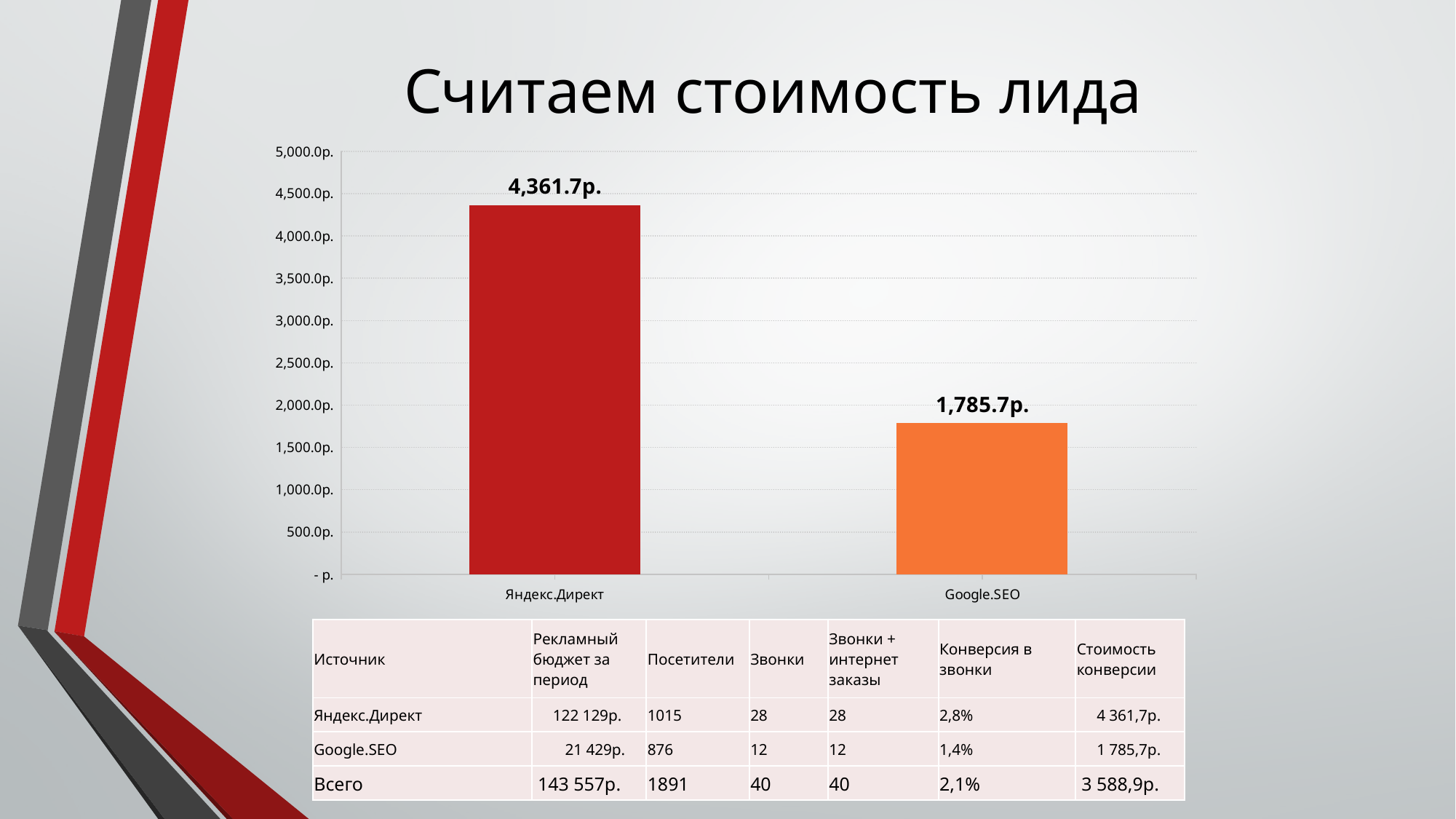
What kind of chart is shown on the slide? bar chart What is the value shown for Яндекс.Директ in the chart? 4,361.7р. Which category has the highest value in the chart? Яндекс.Директ What is the difference between the values for Яндекс.Директ and Google.SEO in the chart? 2,576.0р. What is the title of the slide containing the chart? Считаем стоимость лида What is the value shown for Google.SEO in the chart? 1,785.7р. Which is larger in the chart: the value for Яндекс.Директ or the value for Google.SEO? Яндекс.Директ Is the value for Google.SEO greater or less than 2,000.0р.? less How many categories are shown in the chart? 2 Which category has the lowest value in the chart? Google.SEO Is the value for Яндекс.Директ greater or less than 4,000.0р.? greater What colour is the bar for Google.SEO in the chart? orange